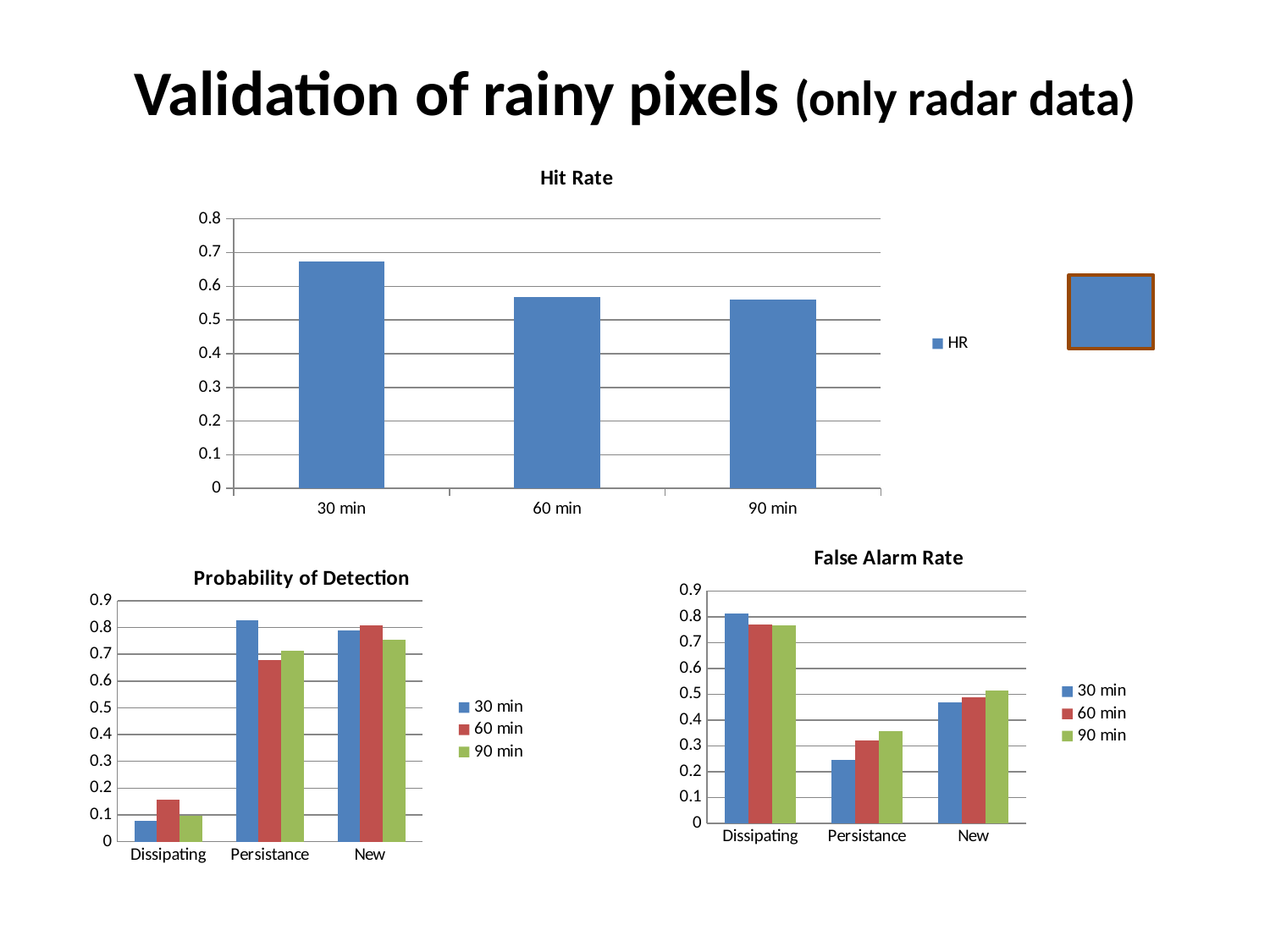
In the Hit Rate chart, do the values rise or fall from 30 min to 90 min? fall How many series does the legend of the Probability of Detection chart list? 3 How many categories are shown on the x axis of the False Alarm Rate chart? 3 In the Probability of Detection chart, is the 30 min value for Persistance greater or less than 0.8? greater In the False Alarm Rate chart, is the 30 min value for Persistance greater or less than 0.3? less What kind of chart is the Hit Rate chart? bar chart In the Probability of Detection chart, which is larger for Dissipating: the 30 min value or the 60 min value? 60 min In the Hit Rate chart, which lead time has the highest hit rate? 30 min In the False Alarm Rate chart, which category has the highest false alarm rate? Dissipating In the Hit Rate chart, is the value for 30 min greater or less than 0.6? greater In the Probability of Detection chart, which category has the lowest values? Dissipating